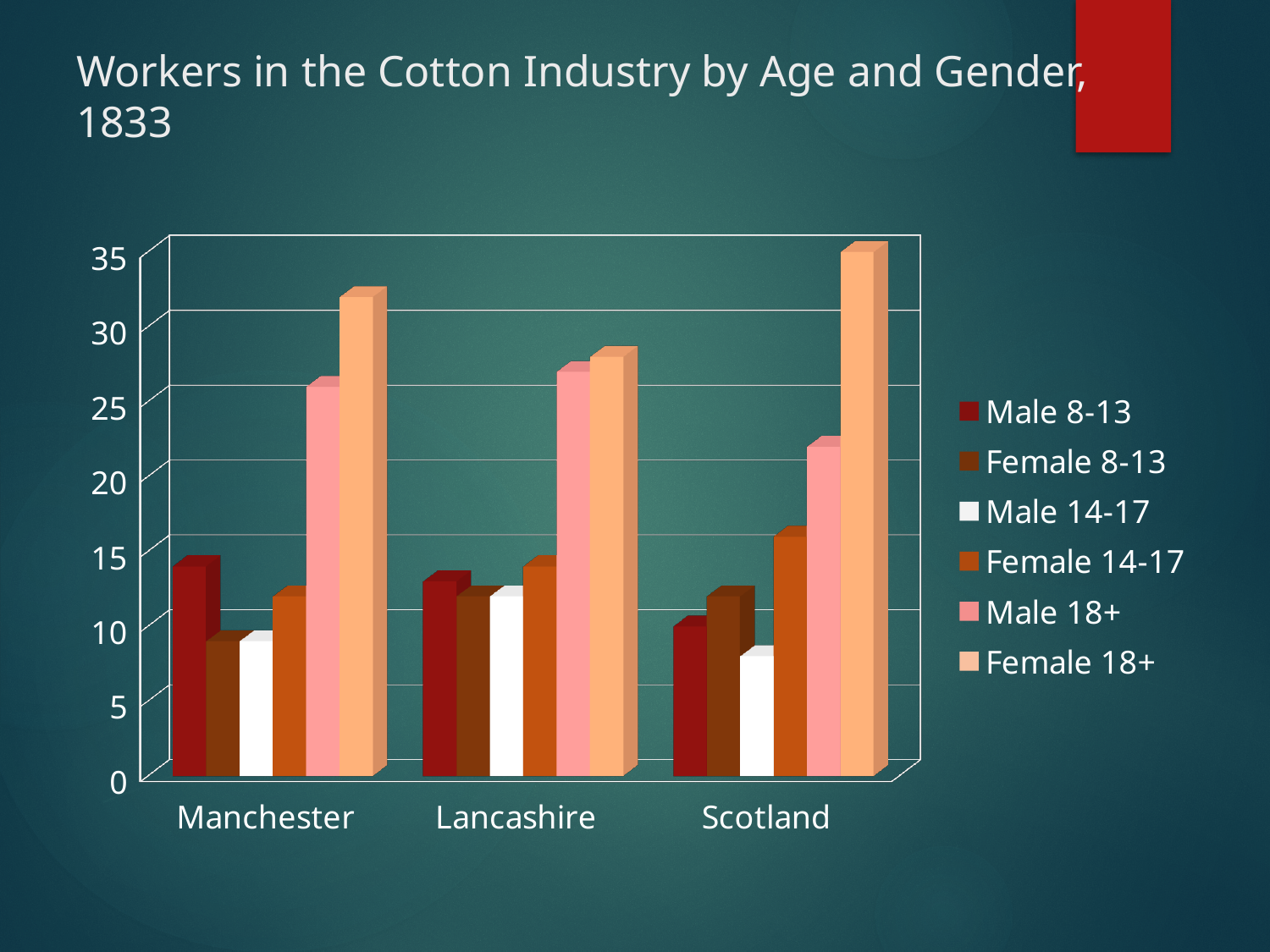
Which series is shown in white in the legend? Male 14-17 What kind of chart is shown on the slide? bar chart Is the value for Male 8-13 in Manchester greater or less than 10? greater In Manchester, which is larger: Male 8-13 or Female 8-13? Male 8-13 Which region has the highest Female 18+ bar? Scotland In Scotland, which is larger: Female 14-17 or Male 14-17? Female 14-17 What is the title of the slide? Workers in the Cotton Industry by Age and Gender, 1833 Is the value for Female 18+ in Manchester greater or less than 30? greater Is the value for Male 18+ in Scotland greater or less than 25? less Which region has the lowest Male 14-17 bar? Scotland How many regions are shown on the x axis? 3 How many series does the legend list? 6